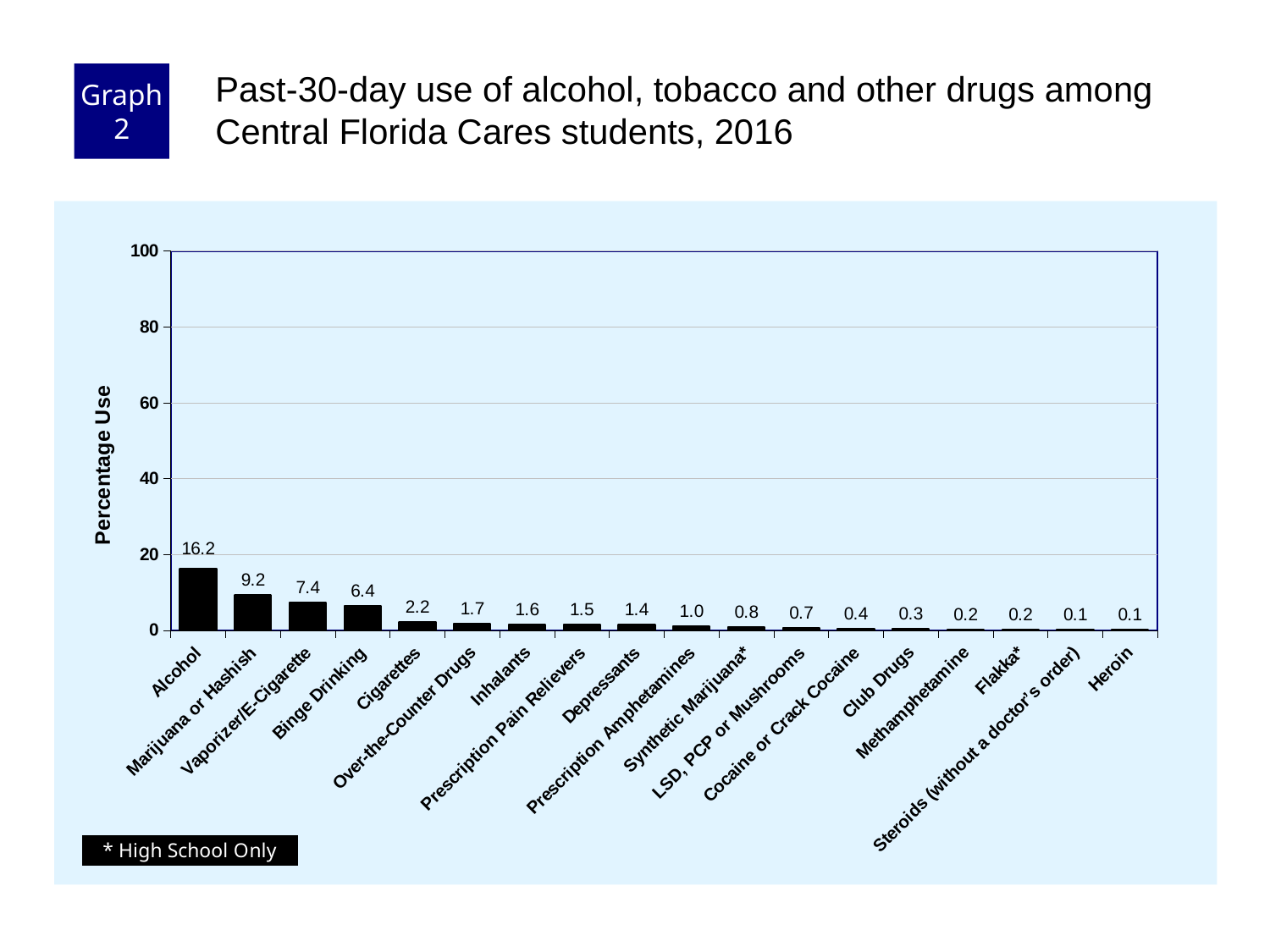
Which has a higher percentage use, Vaporizer/E-Cigarette or Binge Drinking? Vaporizer/E-Cigarette What kind of chart is shown on the slide? bar chart What is the percentage use for Alcohol? 16.2 What is the label of the y axis? Percentage Use How many categories are shown on the x axis? 18 What is the difference in percentage use between Alcohol and Marijuana or Hashish? 7.0 What is the difference in percentage use between Cigarettes and Over-the-Counter Drugs? 0.5 What is the percentage use for Cocaine or Crack Cocaine? 0.4 What is the percentage use for Inhalants? 1.6 Is the value for Alcohol greater or less than 20? less What is the percentage use for Binge Drinking? 6.4 Which category has the highest percentage use? Alcohol